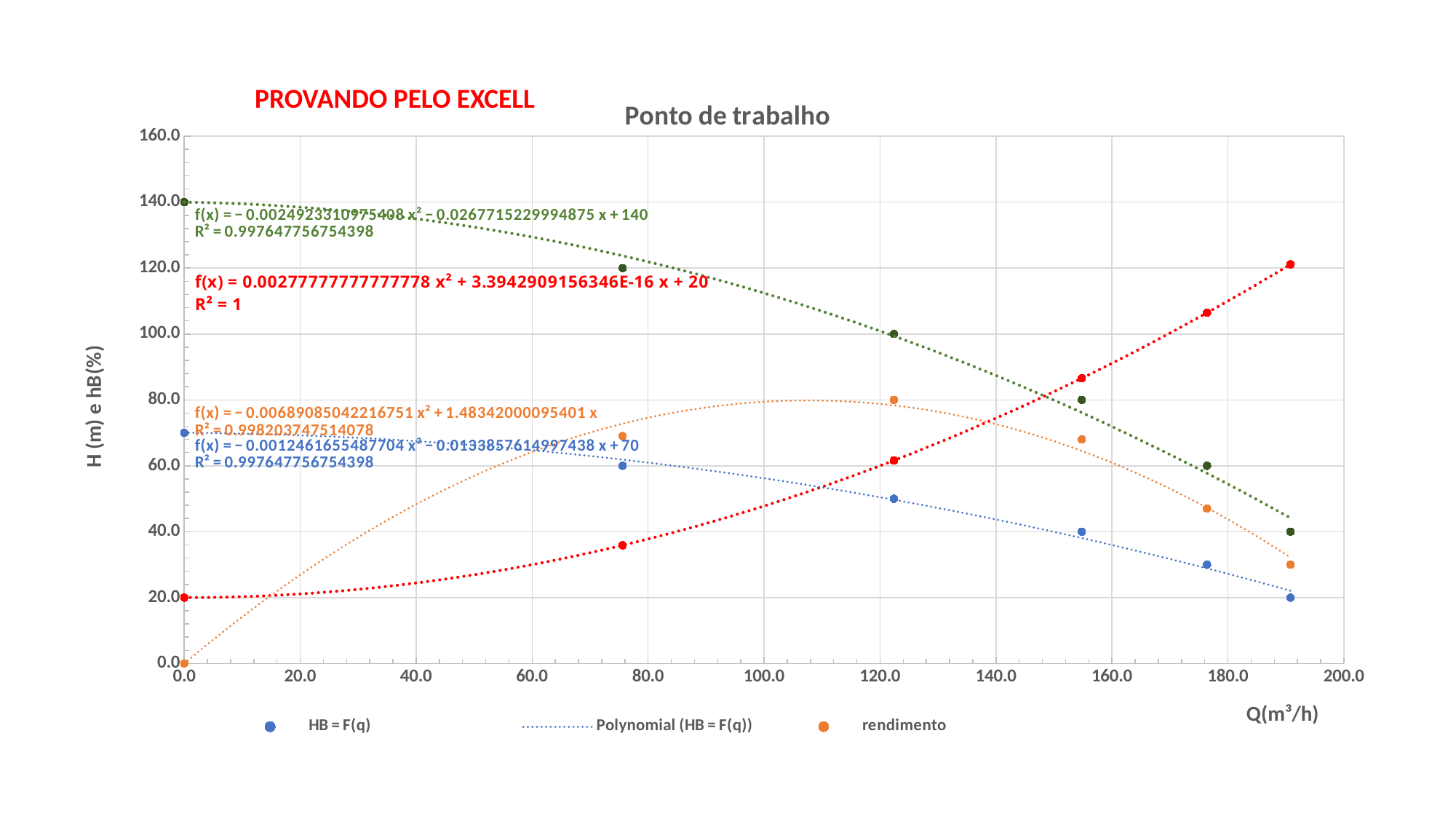
What R² value is shown for the red trendline equation? R² = 1 Is the value of the rightmost HB = F(q) point (near Q = 190) greater or less than 40? less Do the HB = F(q) values rise or fall as Q increases along the x axis? fall How many data points are plotted for the HB = F(q) series? 6 What is the title of the chart? Ponto de trabalho What kind of chart is shown on the slide? scatter chart Is the rendimento value at Q = 0 greater or less than 20? less Do the red series values rise or fall as Q increases along the x axis? rise Is the rendimento value at Q of about 120 greater or less than 60? greater At the rightmost Q value (about 190), which is higher: the red series or the blue HB = F(q) series? red series How many series does the chart legend list? 3